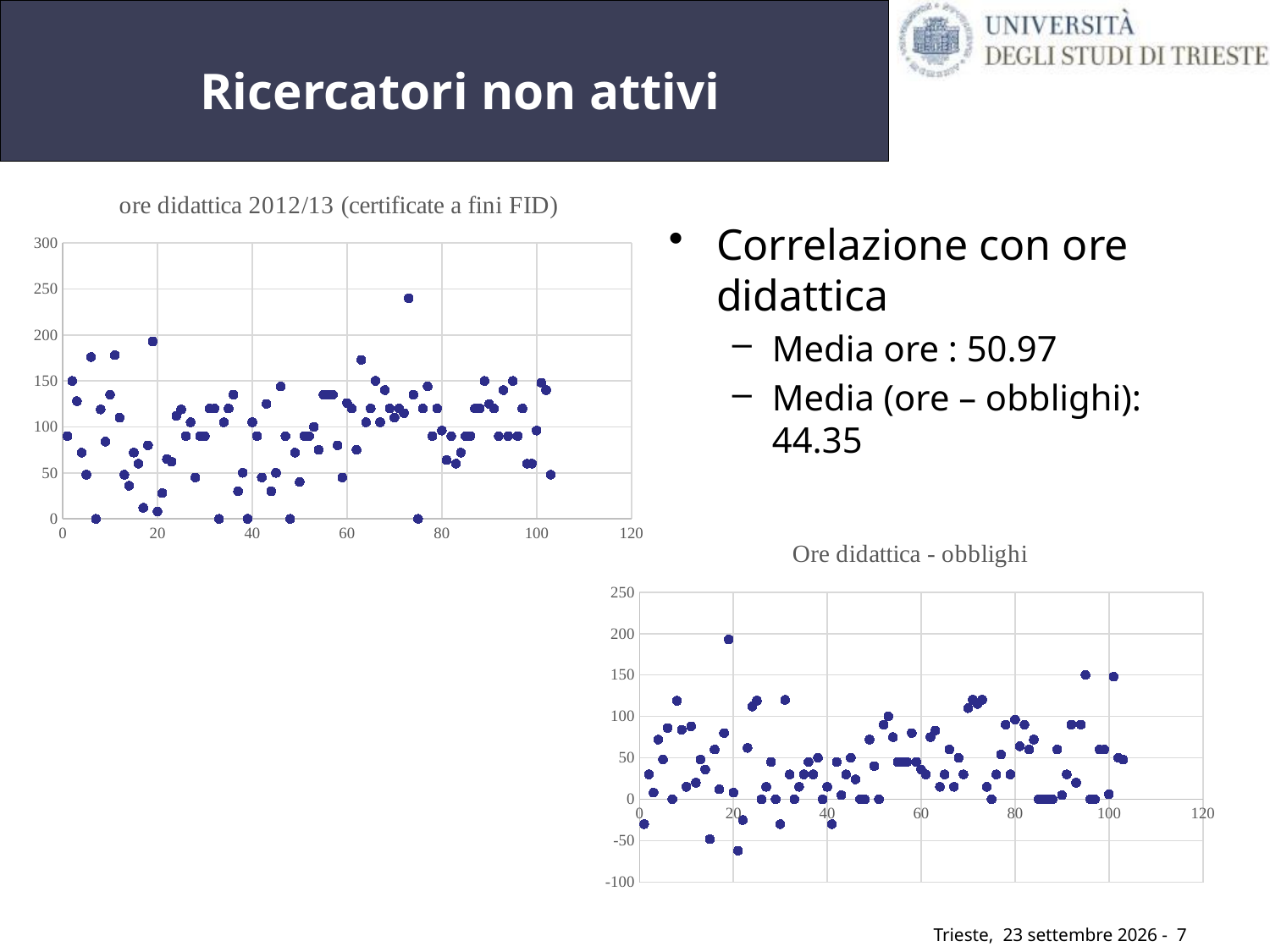
In the chart 'Ore didattica - obblighi', is the lowest plotted point greater or less than 0? less What kind of chart is the chart titled 'ore didattica 2012/13 (certificate a fini FID)'? scatter chart In the chart 'Ore didattica - obblighi', is the lowest plotted point greater or less than -100? greater In the chart 'ore didattica 2012/13 (certificate a fini FID)', is the highest plotted point greater or less than 200? greater What is the title of the chart in the lower right of the slide? Ore didattica - obblighi What kind of chart is the chart titled 'Ore didattica - obblighi'? scatter chart What is the title of the chart in the upper left of the slide? ore didattica 2012/13 (certificate a fini FID)